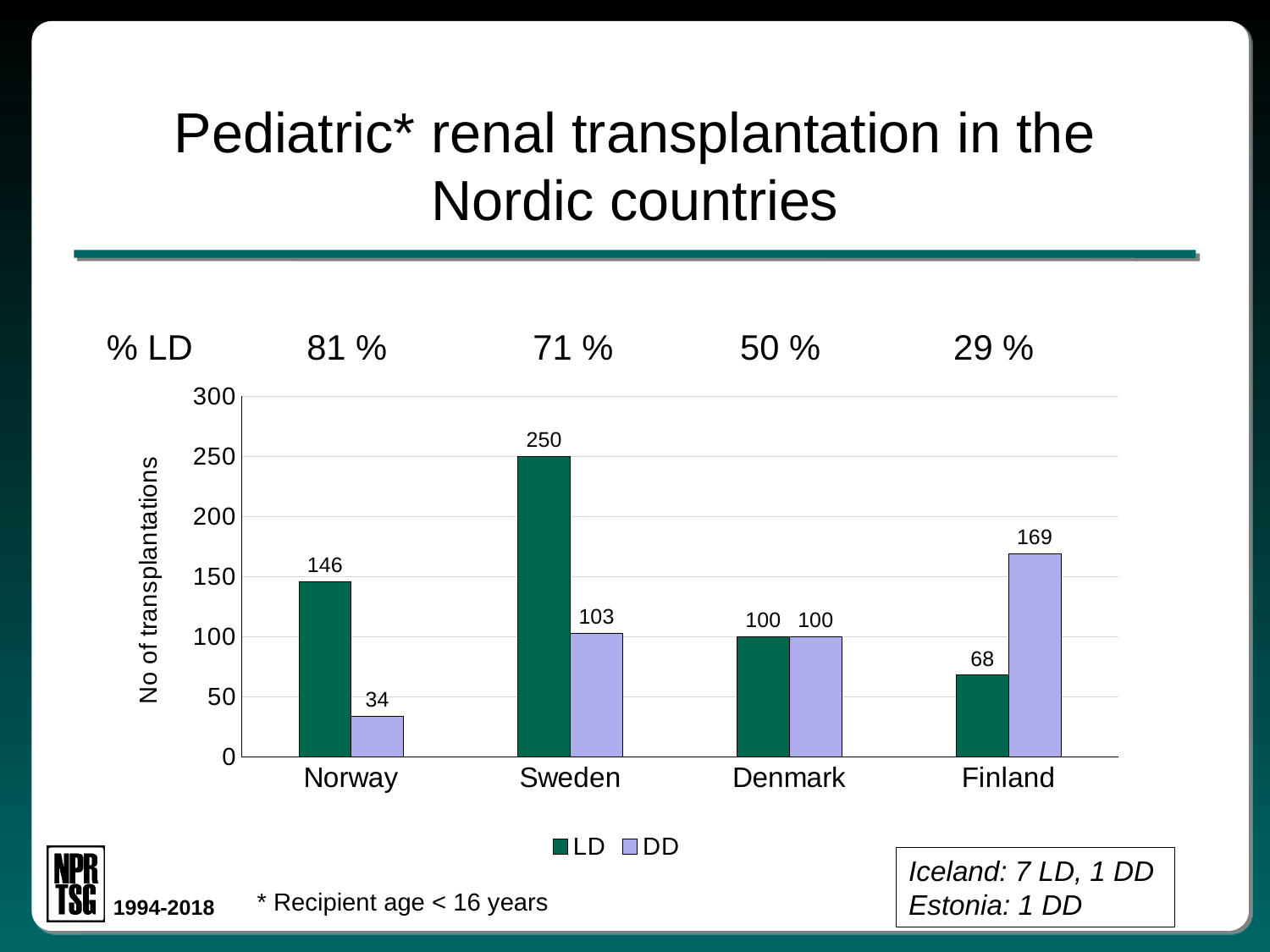
How many series does the legend list? 2 What is the label of the y axis? No of transplantations How many countries are shown on the x axis? 4 Which country has the lowest DD value? Norway What is the LD value for Sweden? 250 What kind of chart is shown? bar chart What is the DD value for Finland? 169 What is the DD value for Norway? 34 What is the difference between the LD and DD values for Norway? 112 Which is larger for Finland, the LD value or the DD value? DD Is the LD value for Sweden greater or less than 200? greater Which country has the highest LD value? Sweden